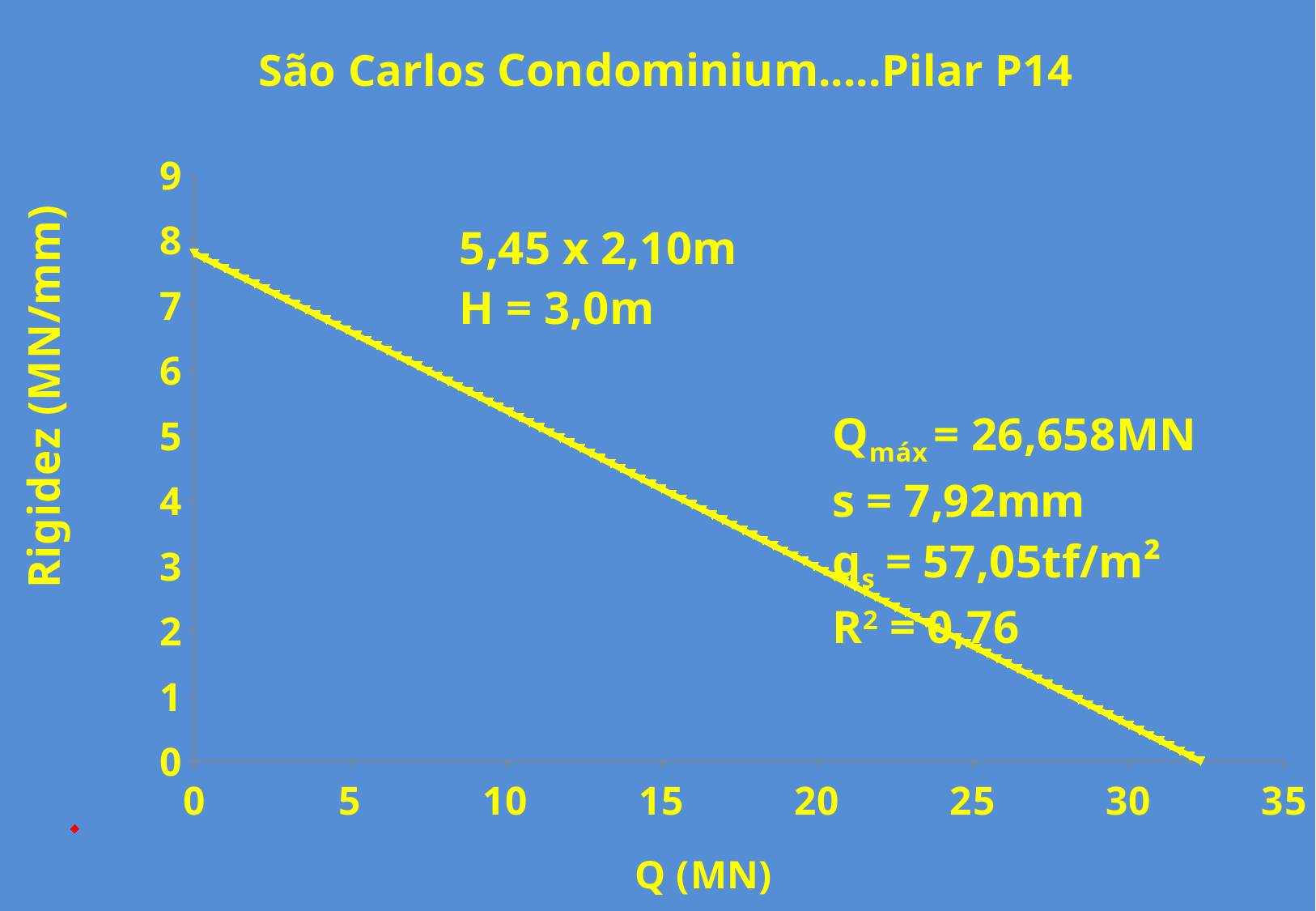
At which Q value is the Rigidez highest? 0 Is the Rigidez value at Q = 30 MN greater or less than 1? less Which has the larger Rigidez value, Q = 5 MN or Q = 25 MN? Q = 5 MN Is the Rigidez value at Q = 15 MN greater or less than 5? less What is the title of the chart? São Carlos Condominium.....Pilar P14 What kind of chart is shown on the slide? line chart What R² value is printed on the chart? 0,76 Is the Rigidez value at Q = 5 MN greater or less than 6? greater Does the Rigidez value rise or fall as Q increases along the x axis? fall